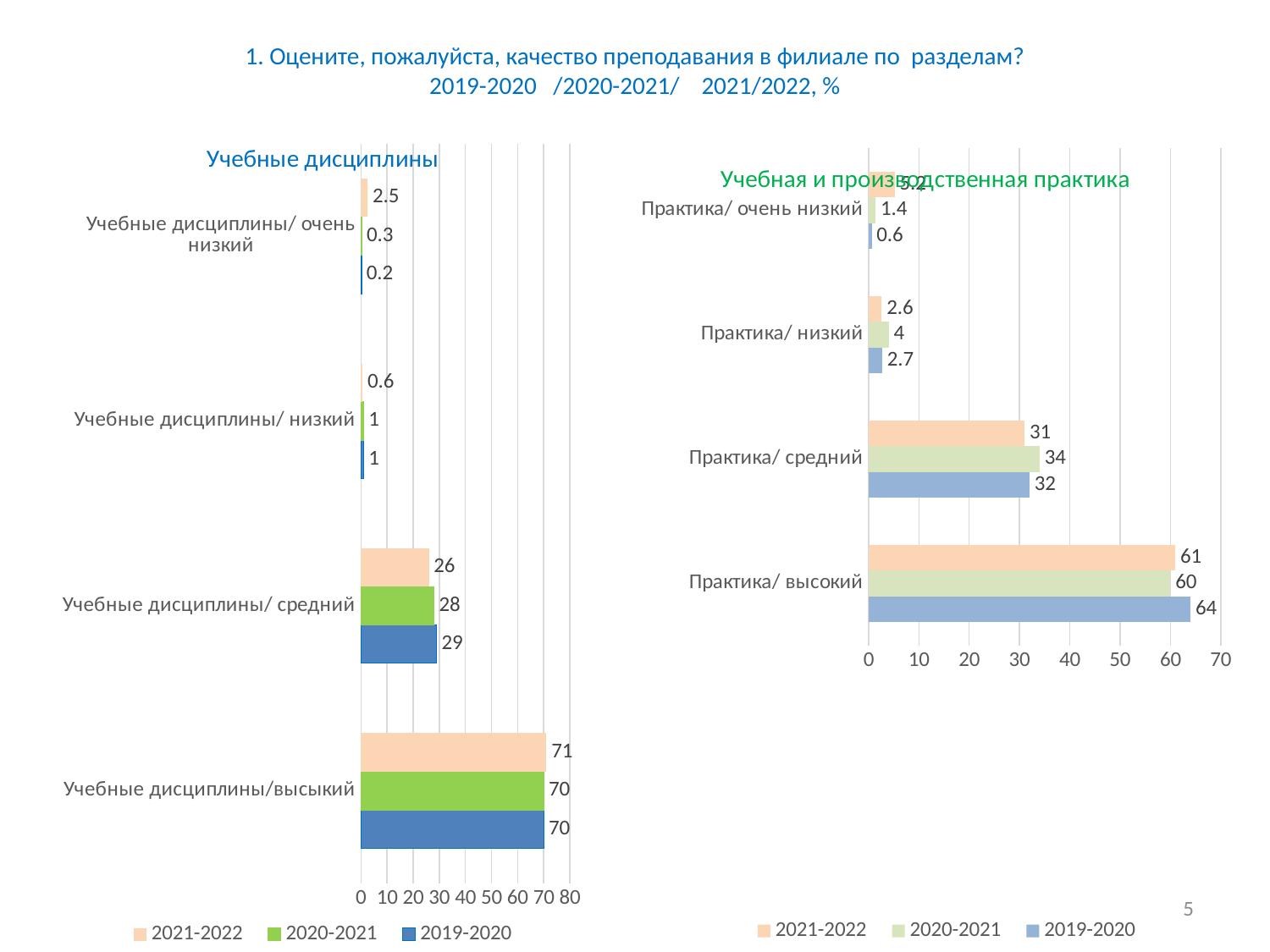
In the chart titled "Учебные дисциплины", what is the difference between the 2019-2020 and 2021-2022 values for "Учебные дисциплины/ средний"? 3 In the chart titled "Учебная и производственная практика", which series has the larger value for "Практика/ высокий": 2021-2022 or 2019-2020? 2019-2020 In the chart titled "Учебная и производственная практика", what is the value for "Практика/ средний" in the 2020-2021 series? 34 In the chart titled "Учебная и производственная практика", what is the difference between the 2019-2020 and 2020-2021 values for "Практика/ высокий"? 4 What type of chart is the chart titled "Учебная и производственная практика"? Bar chart In the chart titled "Учебные дисциплины", what is the value for "Учебные дисциплины/высыкий" in the 2021-2022 series? 71 How many series does the legend of the chart titled "Учебные дисциплины" list? 3 In the chart titled "Учебные дисциплины", what is the value for "Учебные дисциплины/ средний" in the 2019-2020 series? 29 In the chart titled "Учебные дисциплины", which category has the highest values across all series? Учебные дисциплины/высыкий In the chart titled "Учебная и производственная практика", what is the value for "Практика/ низкий" in the 2021-2022 series? 2.6 In the chart titled "Учебные дисциплины", what is the value for "Учебные дисциплины/ очень низкий" in the 2021-2022 series? 2.5 In the chart titled "Учебная и производственная практика", what is the value for "Практика/ высокий" in the 2019-2020 series? 64